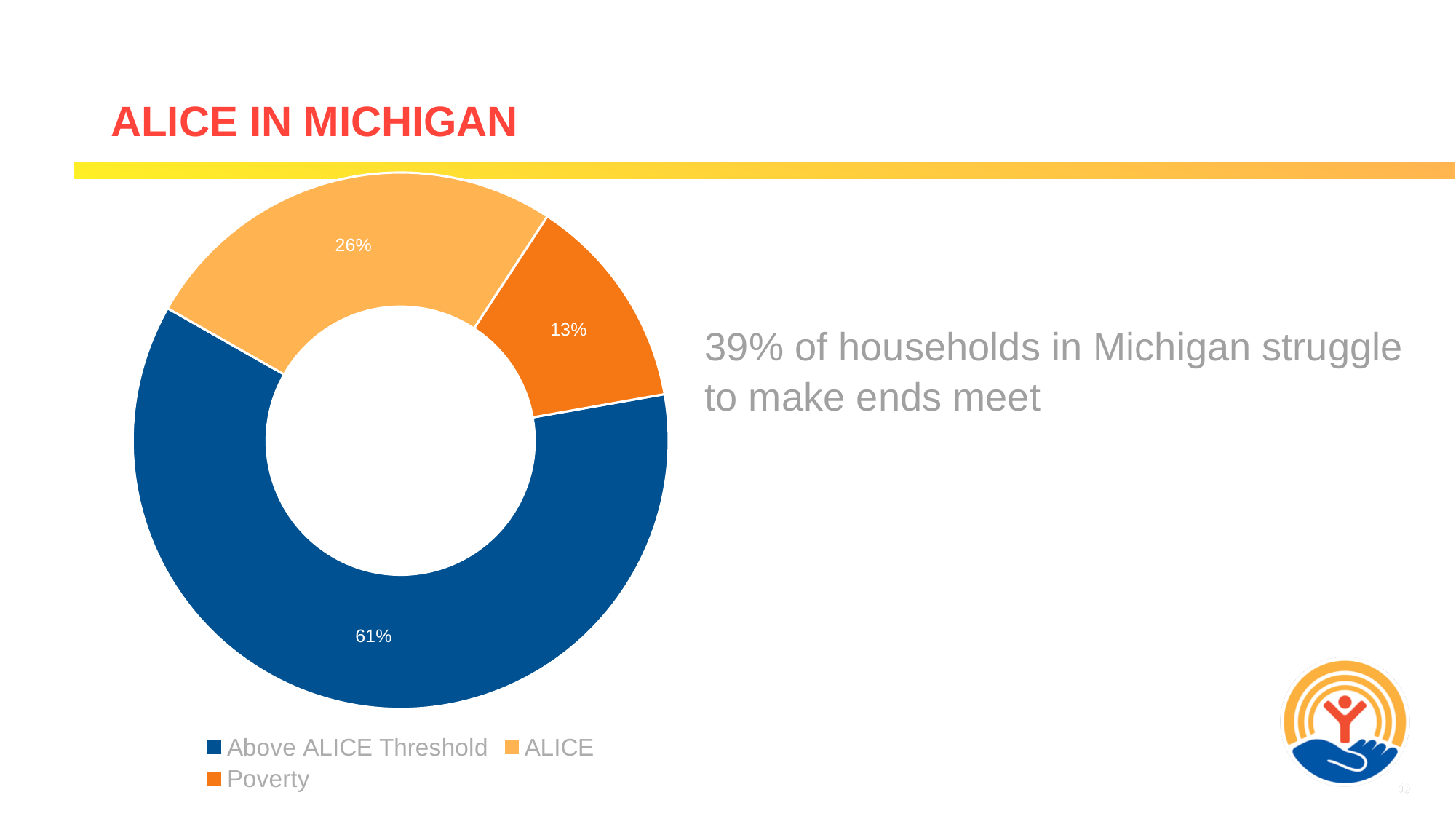
What colour represents the Poverty category in the chart? Dark orange What percentage of households are in Poverty? 13% Which category has the smallest share of the chart? Poverty What is the difference in percentage points between the ALICE and Poverty shares? 13 What percentage of households are Above ALICE Threshold? 61% How many categories does the chart show? 3 Which category has the largest share of the chart? Above ALICE Threshold What kind of chart is shown on the slide? Doughnut (pie) chart What is the difference in percentage points between Above ALICE Threshold and ALICE? 35 What percentage of households are ALICE? 26% Which is larger, the ALICE share or the Poverty share? ALICE What is the combined share of the ALICE and Poverty categories? 39%